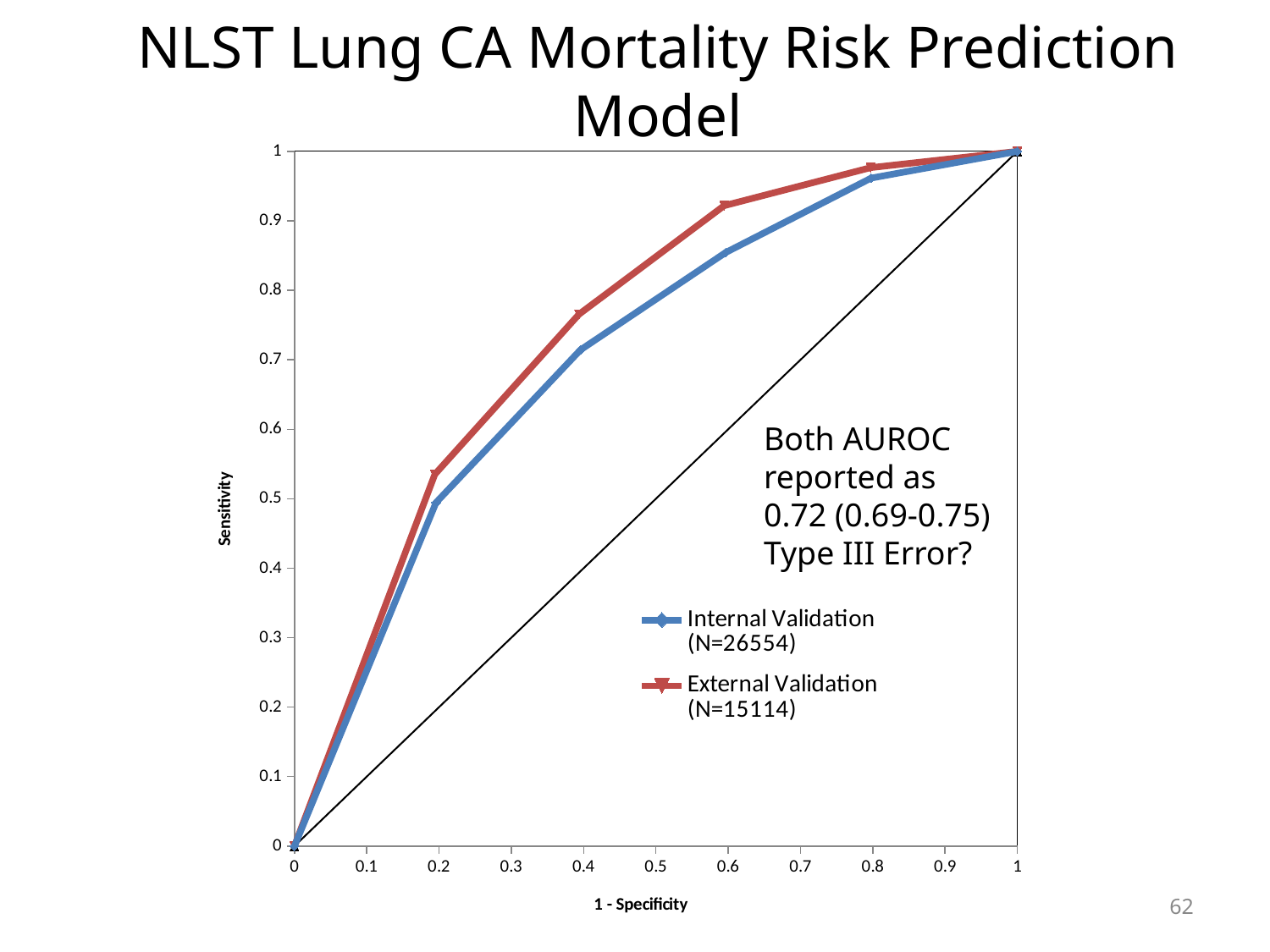
How many series does the legend list? 2 What kind of chart is shown on the slide? line chart Is the sensitivity for Internal Validation (N=26554) at 1 - Specificity of 0.4 greater or less than 0.6? greater What is the title of the slide's chart? NLST Lung CA Mortality Risk Prediction Model Is the sensitivity for External Validation (N=15114) at 1 - Specificity of 0.2 greater or less than 0.5? greater What is the label of the vertical axis? Sensitivity Is the sensitivity for External Validation (N=15114) at 1 - Specificity of 0.6 greater or less than 0.9? greater How many data points are plotted for the External Validation (N=15114) series? 6 Does the sensitivity for Internal Validation (N=26554) rise or fall as 1 - Specificity increases from 0 to 1? rise At 1 - Specificity of 0.4, which series has the higher sensitivity, Internal Validation (N=26554) or External Validation (N=15114)? External Validation (N=15114)